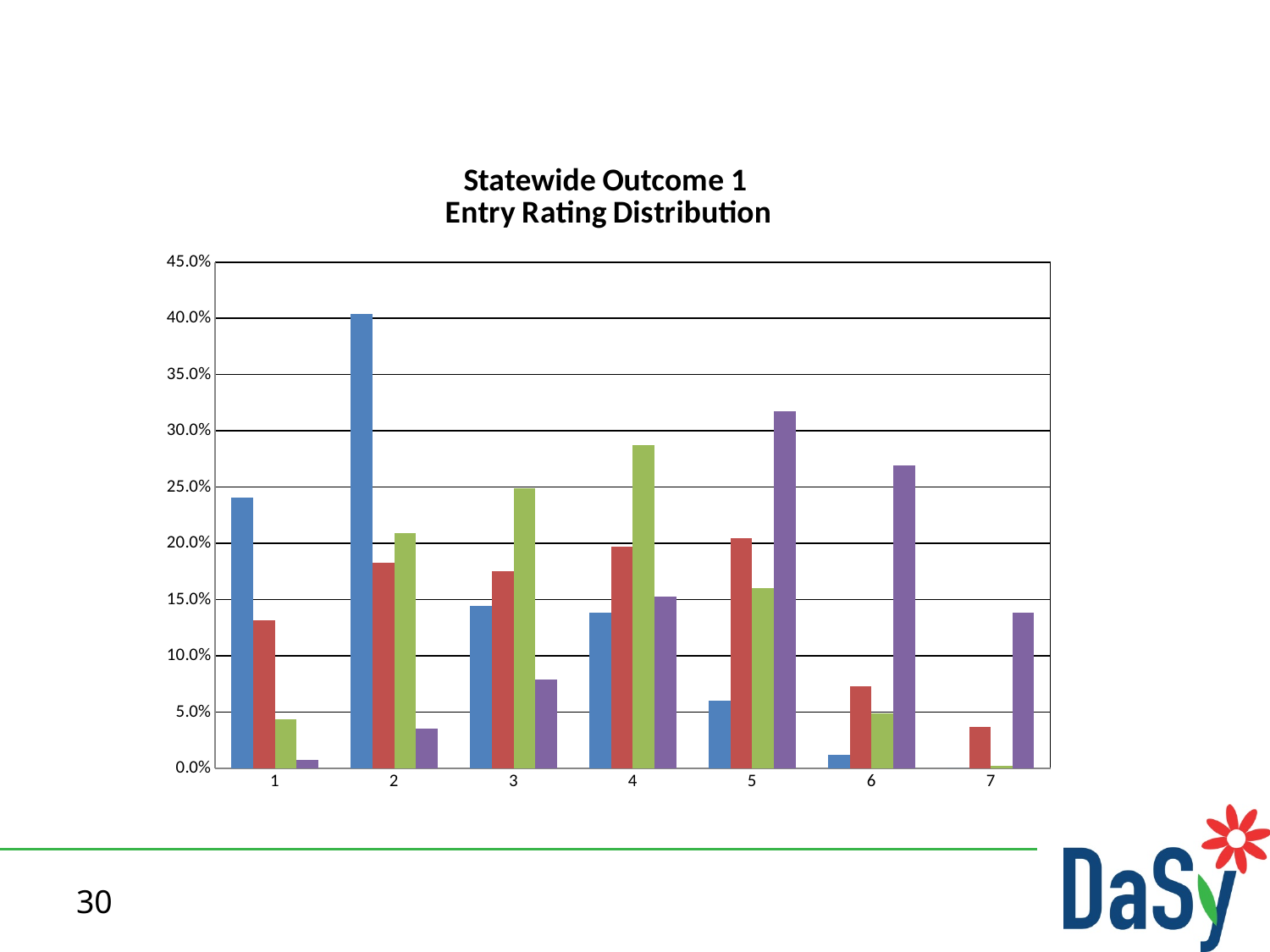
Is the value of the blue bar for category 2 greater or less than 35%? greater For category 4, which is larger, the green bar or the red bar? green bar What is the title of the chart? Statewide Outcome 1 Entry Rating Distribution Which category has the tallest purple bar? 5 Which category has the tallest blue bar? 2 Is the value of the purple bar for category 5 greater or less than 30%? greater Which category has the tallest green bar? 4 Do the blue bars generally rise or fall from category 2 to category 7? fall How many differently coloured bars are shown for each category? 4 Is the value of the green bar for category 1 greater or less than 5%? less How many categories are shown on the x axis? 7 What kind of chart is shown on the slide? bar chart